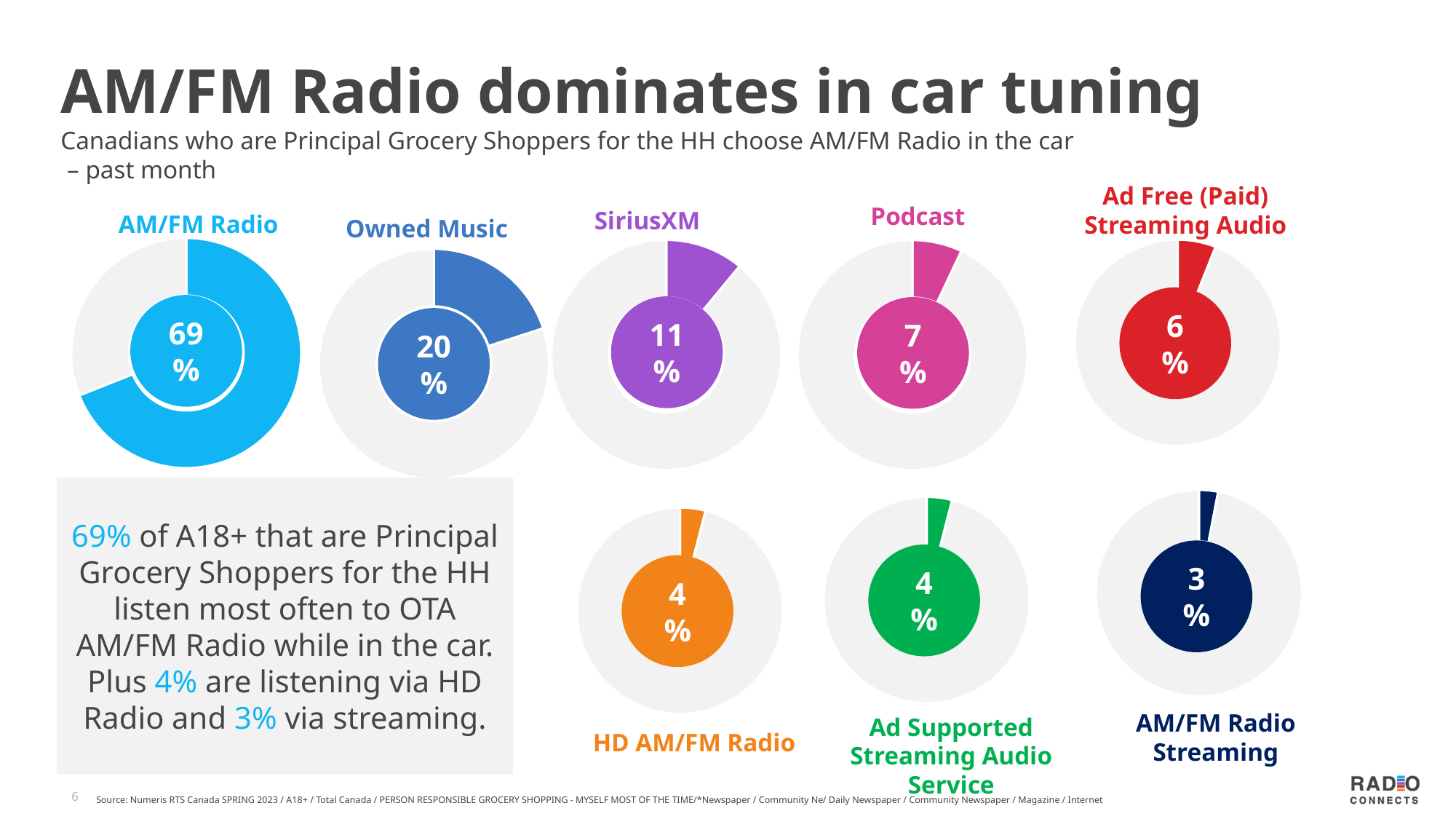
Which is larger, the SiriusXM value or the Podcast value? SiriusXM What value is shown on the AM/FM Radio Streaming chart? 3% What value is shown on the AM/FM Radio chart? 69% What is the difference between the AM/FM Radio value and the Owned Music value? 49 percentage points How many charts are shown on the slide? 8 What kind of chart is used for the HD AM/FM Radio value? doughnut chart What value is shown on the Owned Music chart? 20% What value is shown on the Podcast chart? 7% Across all the charts on the slide, which category has the highest value? AM/FM Radio Across all the charts on the slide, which category has the lowest value? AM/FM Radio Streaming What value is shown on the Ad Free (Paid) Streaming Audio chart? 6% What value is shown on the SiriusXM chart? 11%